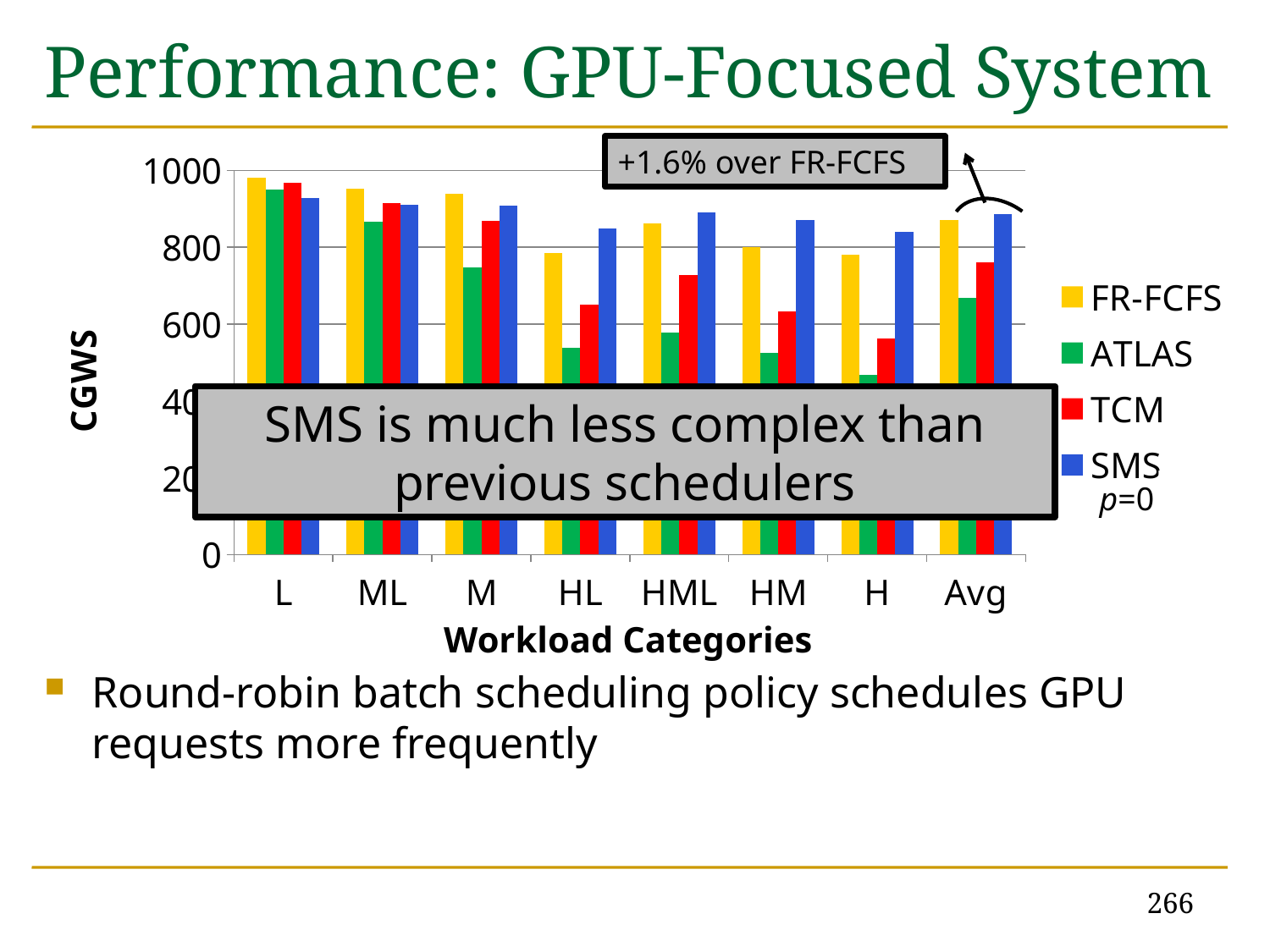
In which workload category is the ATLAS value lowest? H For workload category HM, which is larger, the SMS value or the TCM value? SMS How many workload categories are shown on the x axis? 8 Is the SMS value for workload category HML greater or less than 800? greater Is the FR-FCFS value for workload category L greater or less than 800? greater How many series does the legend list? 4 What is the label on the y axis of the chart? CGWS In which workload category is the ATLAS value highest? L Is the ATLAS value for workload category M greater or less than 800? less What kind of chart is shown on the slide? bar chart For workload category HL, which is larger, the FR-FCFS value or the ATLAS value? FR-FCFS